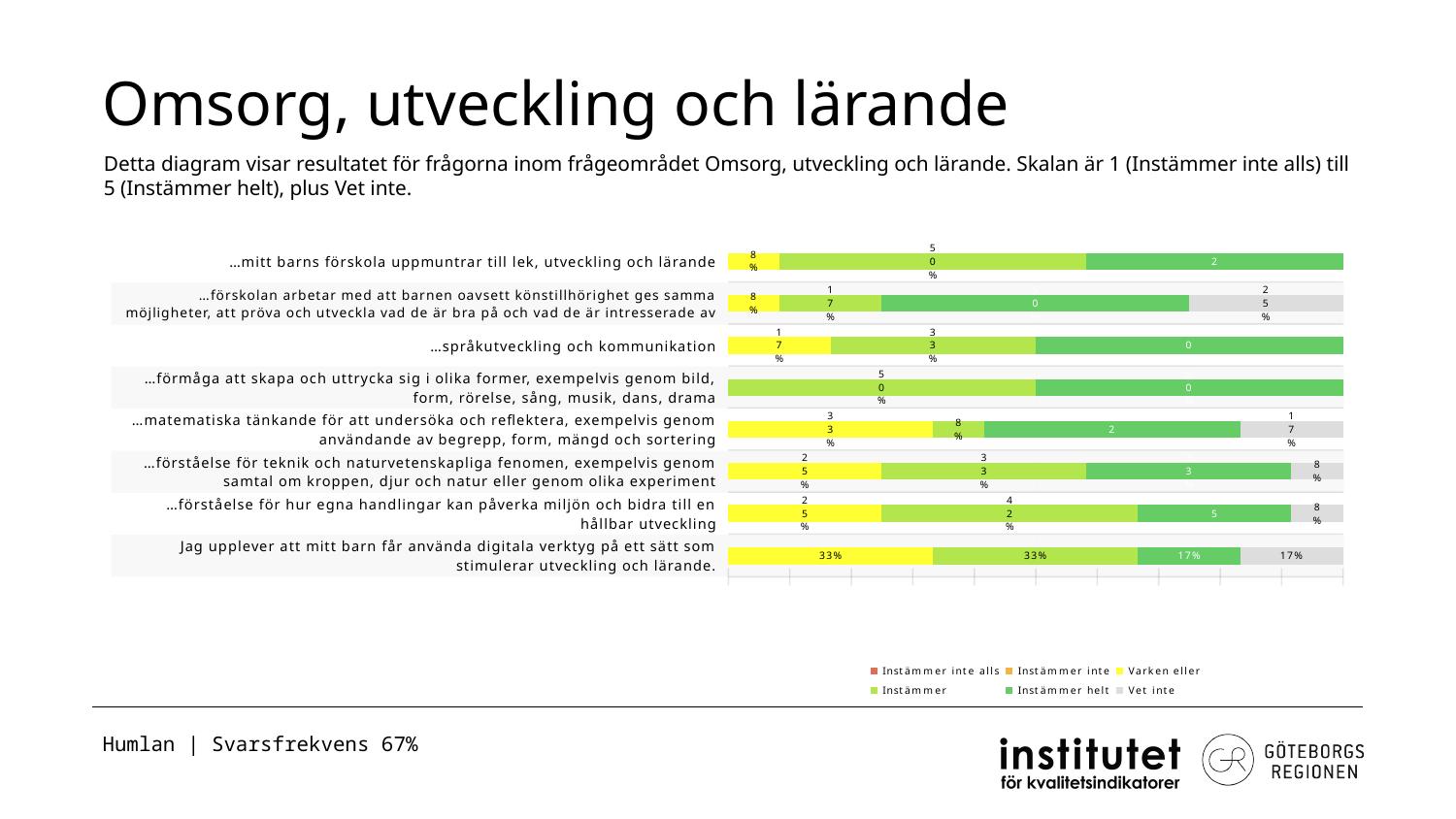
What is the 'Vet inte' share for '…förskolan arbetar med att barnen oavsett könstillhörighet ges samma möjligheter'? 25% How many series does the legend list? 6 Which question has the highest 'Vet inte' share? …förskolan arbetar med att barnen oavsett könstillhörighet ges samma möjligheter What is the 'Vet inte' share for 'Jag upplever att mitt barn får använda digitala verktyg på ett sätt som stimulerar utveckling och lärande'? 17% What is the difference in 'Varken eller' share between '…matematiska tänkande' (33%) and '…förståelse för teknik och naturvetenskapliga fenomen' (25%)? 8 percentage points Which has the larger 'Varken eller' share: '…språkutveckling och kommunikation' or '…mitt barns förskola uppmuntrar till lek, utveckling och lärande'? …språkutveckling och kommunikation What is the 'Instämmer' share for '…förståelse för hur egna handlingar kan påverka miljön och bidra till en hållbar utveckling'? 42% What is the 'Varken eller' share for '…matematiska tänkande för att undersöka och reflektera'? 33% What kind of chart is shown on the slide? Stacked bar chart What is the 'Instämmer' share for '…förmåga att skapa och uttrycka sig i olika former'? 50% How many questions (categories) are plotted in the chart? 8 What colour represents 'Vet inte' in the legend? Grey